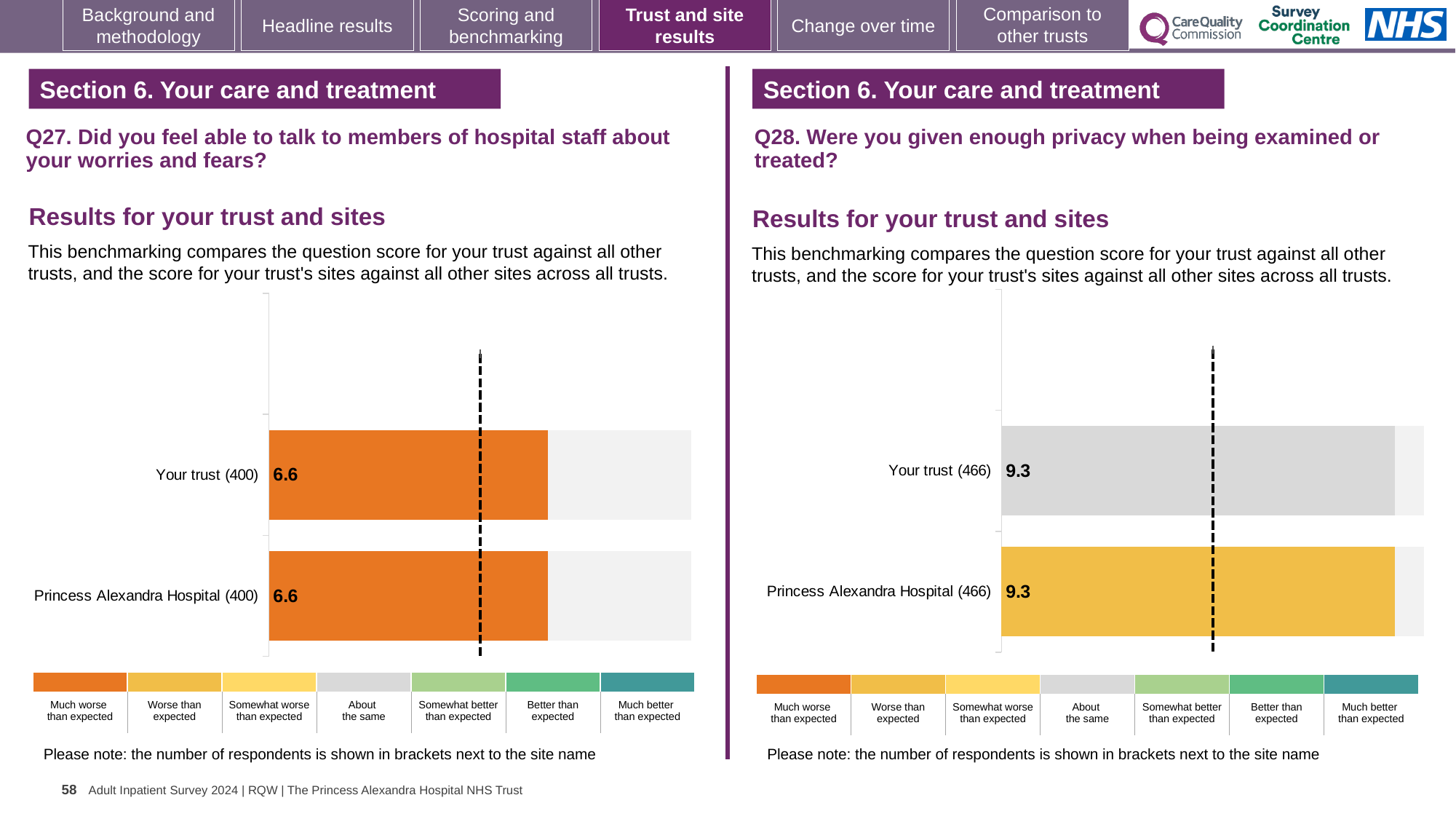
In the Q27 chart on the left, which benchmark category does the colour of the Your trust bar correspond to? Much worse than expected In the Q28 chart on the right, what is the score for Princess Alexandra Hospital? 9.3 In the Q28 chart on the right, what is the score for Your trust? 9.3 In the Q27 chart on the left, what is the difference between the score for Your trust and the score for Princess Alexandra Hospital? 0 In the Q27 chart on the left, what is the score for Princess Alexandra Hospital? 6.6 Is the score for Your trust in the Q28 chart on the right larger or smaller than the score for Your trust in the Q27 chart on the left? Larger In the Q28 chart on the right, which benchmark category does the colour of the Your trust bar correspond to? About the same In the Q27 chart on the left, what is the score for Your trust? 6.6 What kind of chart is the Q27 chart on the left? Bar chart In the Q28 chart on the right, how many bars are plotted? 2 In the Q28 chart on the right, how many respondents are shown in brackets for Princess Alexandra Hospital? 466 In the Q27 chart on the left, how many respondents are shown in brackets for Your trust? 400